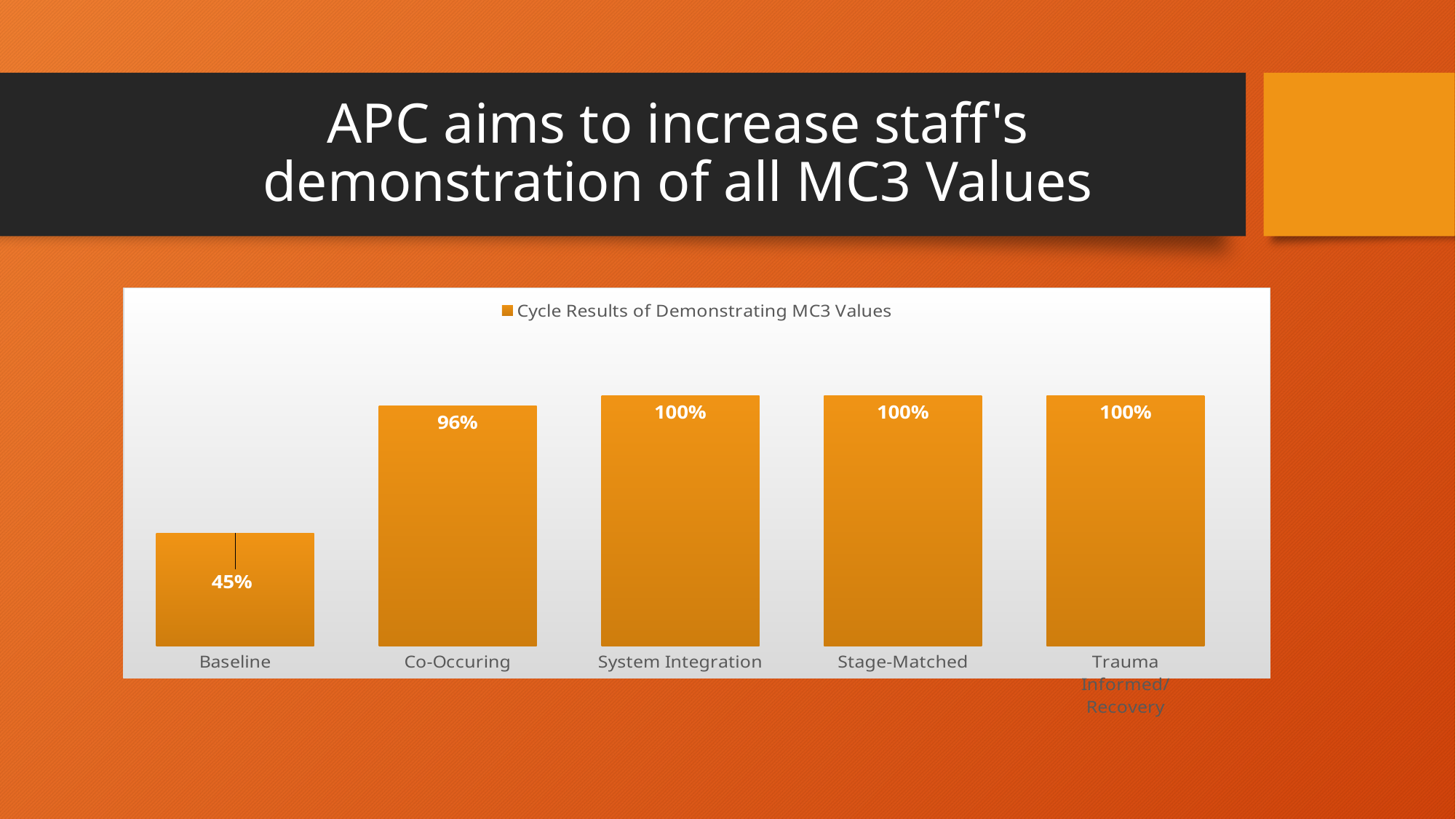
What is the value for System Integration? 100% What is the name of the series shown in the legend? Cycle Results of Demonstrating MC3 Values What is the value for Baseline? 45% What is the difference between the values for Stage-Matched and Co-Occuring? 4% How many categories are shown on the x axis? 5 What is the value for Trauma Informed/Recovery? 100% What is the difference between the values for Co-Occuring and Baseline? 51% What kind of chart is shown on the slide? Bar chart Which category has the lowest value? Baseline Which is larger, the value for Baseline or the value for Co-Occuring? Co-Occuring How many series does the legend list? 1 What is the value for Co-Occuring? 96%